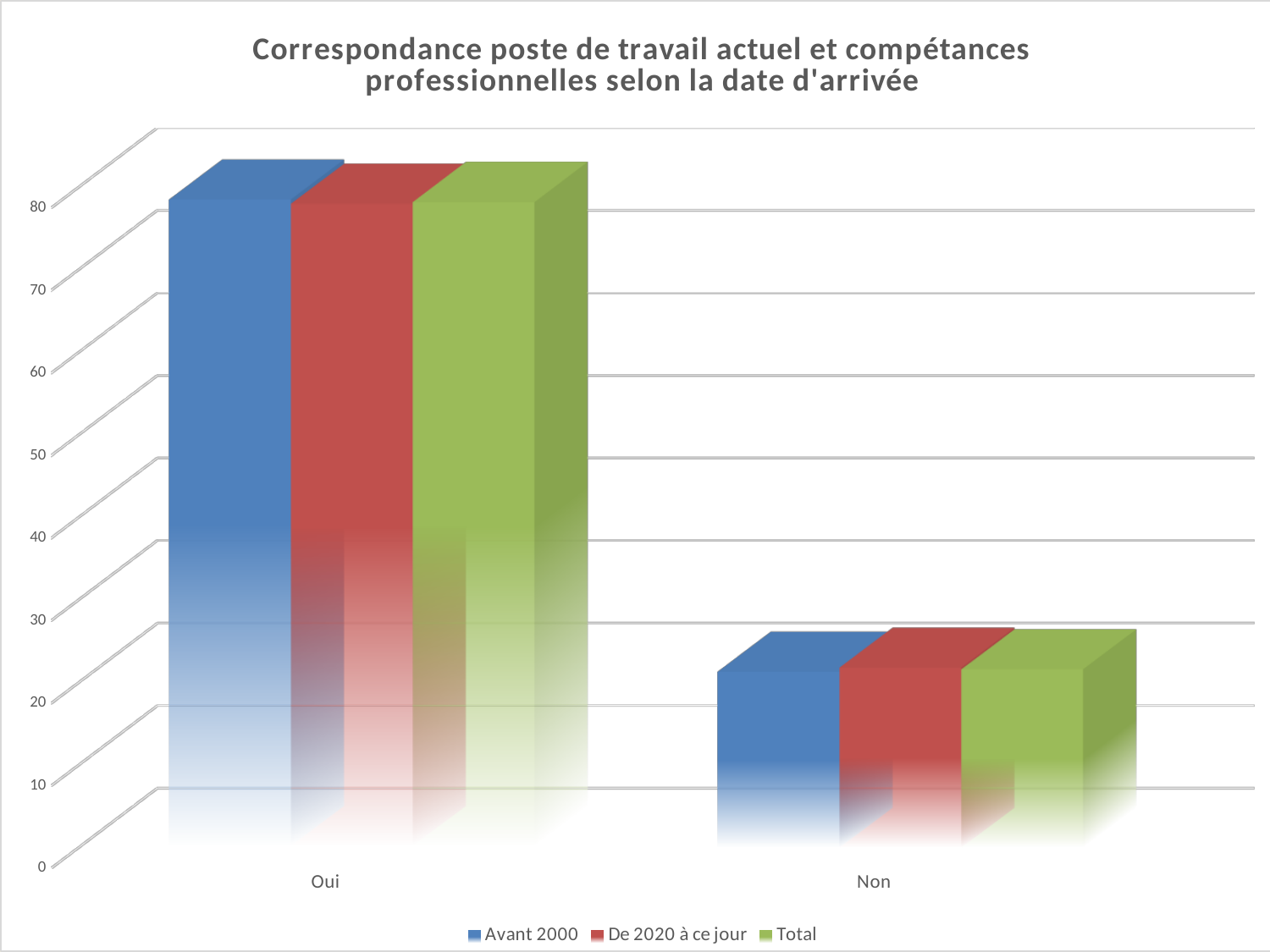
Is the value for Non in the series De 2020 à ce jour greater or less than 40? less For the series De 2020 à ce jour, which category has the larger value, Oui or Non? Oui Is the value for Non in the series Total greater or less than 30? less What kind of chart is shown on the slide? bar chart Is the value for Oui in the series Total greater or less than 60? greater Which category has the lowest value for the series Total? Non How many categories are shown on the x axis? 2 How many series does the legend list? 3 What is the title of the chart? Correspondance poste de travail actuel et compétances professionnelles selon la date d'arrivée Which series is shown in green in the legend? Total Which category has the highest value for the series Avant 2000? Oui